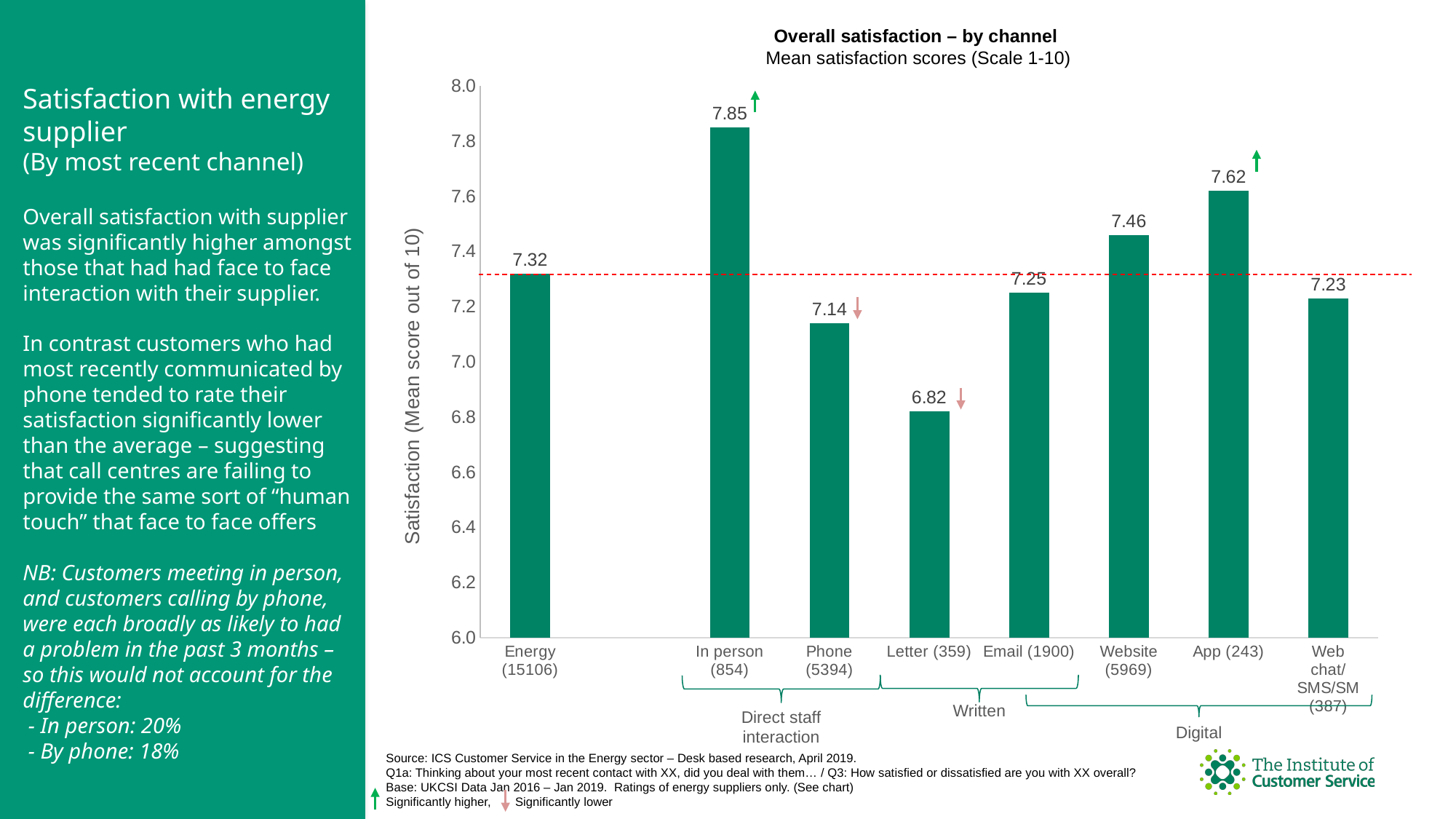
What type of chart is shown on the slide? Bar chart Which has a higher mean satisfaction score, App or Website? App What is the mean satisfaction score for the Website channel? 7.46 What is the mean satisfaction score for the Letter channel? 6.82 What is the mean satisfaction score for Energy overall? 7.32 What is the difference between the In person score and the Phone score? 0.71 What is the mean satisfaction score for the In person channel? 7.85 Which channel has the highest mean satisfaction score? In person Which channel has the lowest mean satisfaction score? Letter Is the value for Letter greater or less than 7.0? less What is the title of the chart? Overall satisfaction – by channel How many bars are shown in the chart? 8